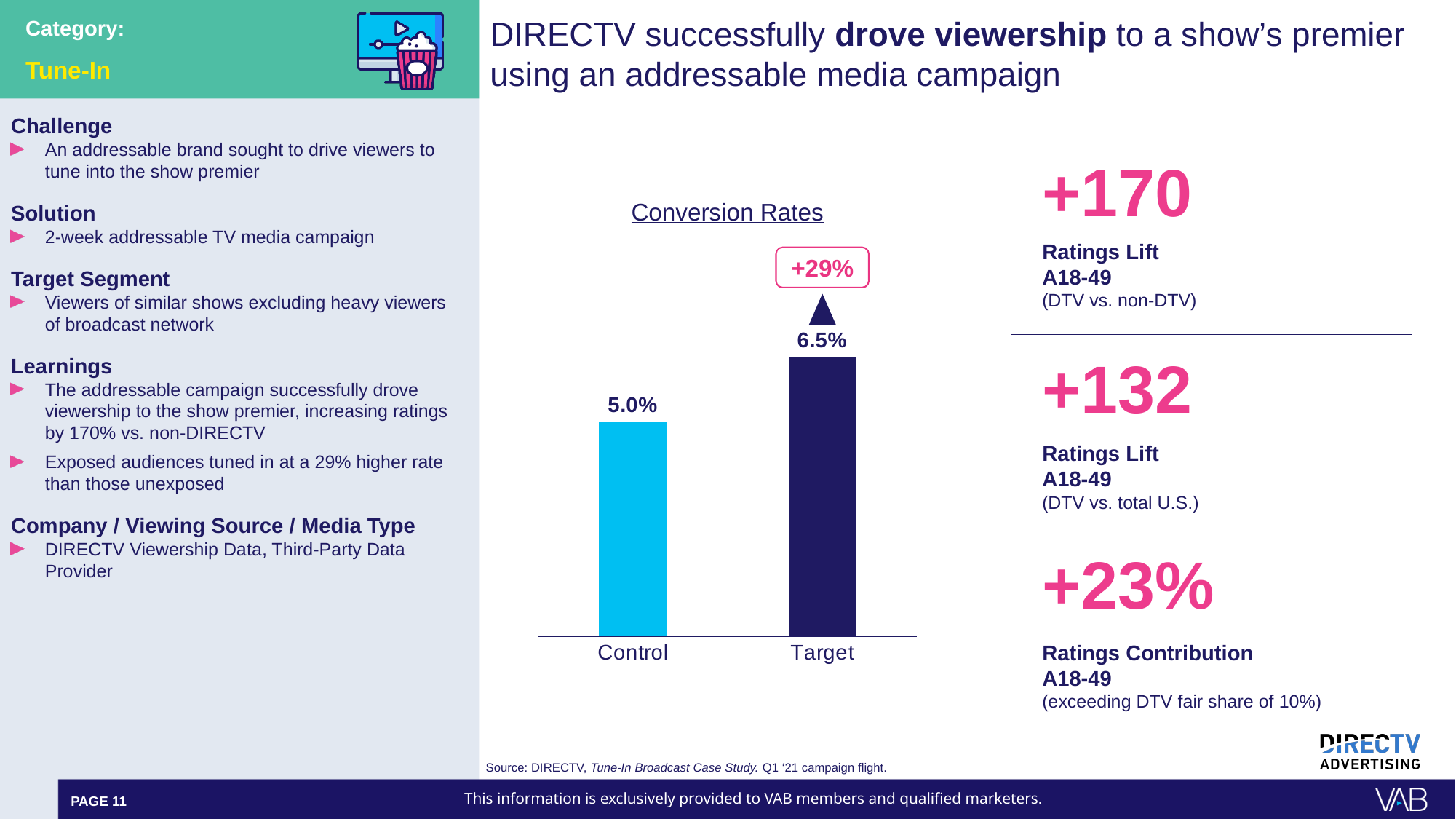
What is the difference in conversion rate between Target and Control? 1.5% Is the conversion rate for Target larger or smaller than that for Control? larger How many categories are shown in the Conversion Rates chart? 2 What is the conversion rate for Target? 6.5% What is the title of the chart? Conversion Rates What kind of chart is the Conversion Rates chart? bar chart Which category has the lower conversion rate? Control Do the conversion rates rise or fall from Control to Target? rise Which category has the higher conversion rate? Target What percentage lift is shown in the callout above the Target bar? +29% What is the conversion rate for Control? 5.0%